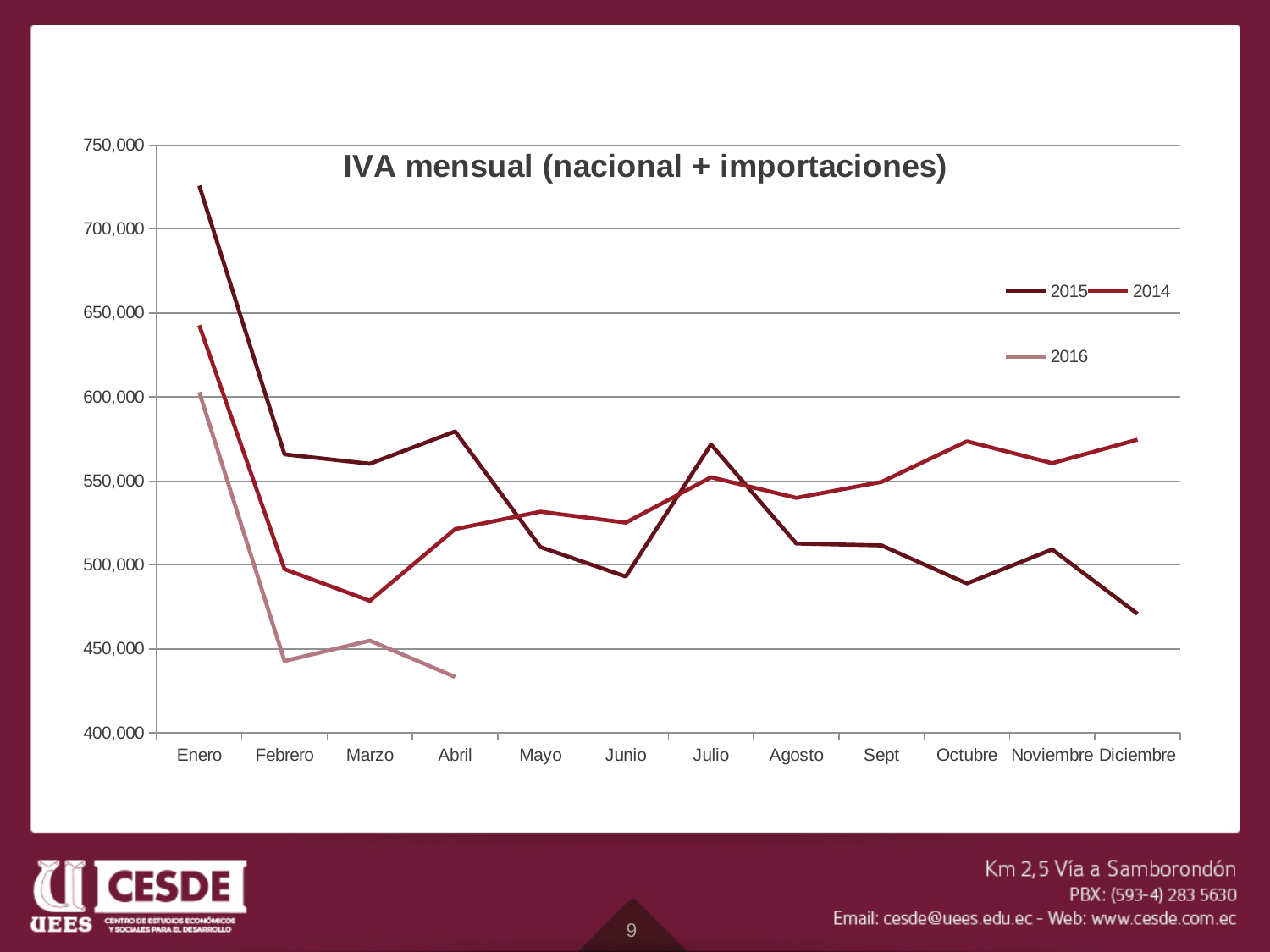
How many months have a plotted value for the 2016 series? 4 How many months are shown on the x axis? 12 Is the value for 2015 in Enero greater or less than 700,000? greater Which series has the higher value in Diciembre, 2014 or 2015? 2014 What kind of chart is shown on the slide? Line chart Is the value for 2014 in Marzo greater or less than 500,000? less Is the value for 2016 in Abril greater or less than 450,000? less Does the 2016 series generally rise or fall from Enero to Abril? Fall In which month does the 2015 series reach its highest value? Enero What is the title of the chart? IVA mensual (nacional + importaciones) How many series does the legend list? 3